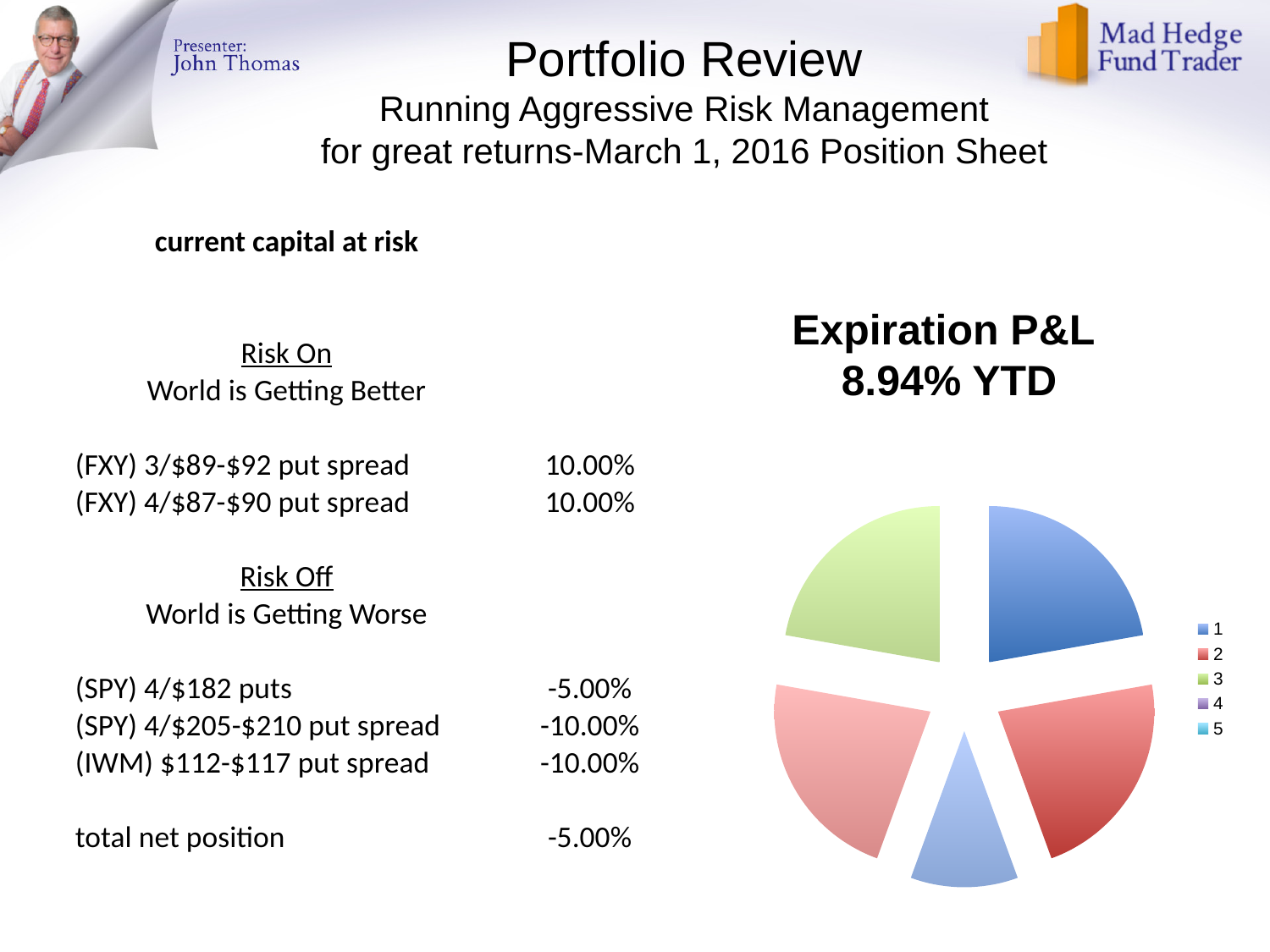
What colour is slice 1 in the pie chart? blue Which slice of the pie chart is the smallest? 5 Which is larger in the pie chart, slice 5 or slice 3? 3 What colour is slice 3 in the pie chart? green How many slices does the pie chart have? 5 How many entries does the pie chart's legend list? 5 What kind of chart is shown on the slide? pie chart Which is larger in the pie chart, slice 2 or slice 5? 2 Which is larger in the pie chart, slice 1 or slice 5? 1